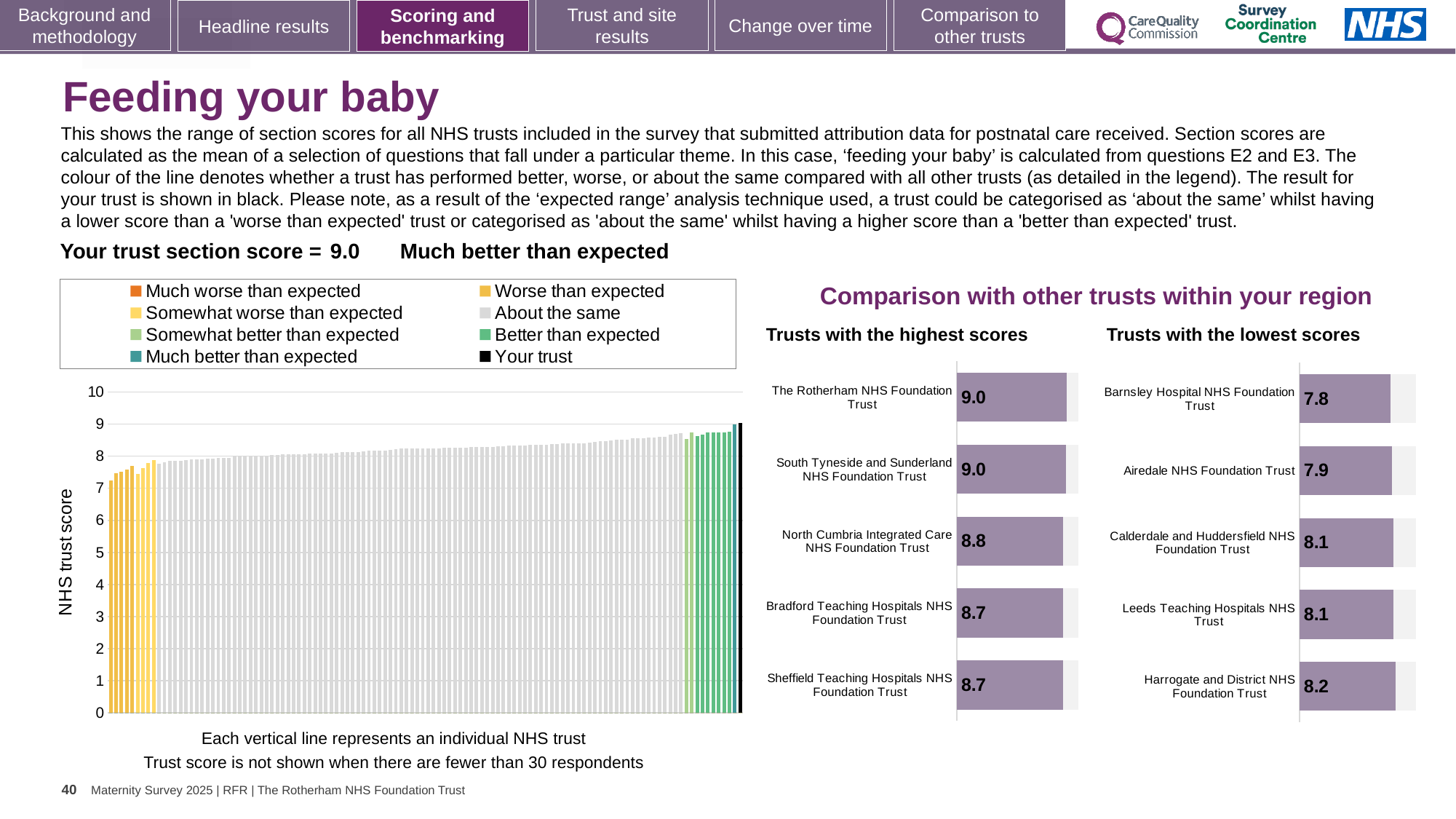
In the 'Trusts with the highest scores' chart, what is the score for North Cumbria Integrated Care NHS Foundation Trust? 8.8 In the main 'NHS trust score' chart, do the bar values rise or fall from left to right? Rise In the 'Trusts with the lowest scores' chart, what is the difference between the score for Harrogate and District NHS Foundation Trust and the score for Barnsley Hospital NHS Foundation Trust? 0.4 In the 'Trusts with the highest scores' chart, which has the larger score: North Cumbria Integrated Care NHS Foundation Trust or Bradford Teaching Hospitals NHS Foundation Trust? North Cumbria Integrated Care NHS Foundation Trust In the 'Trusts with the lowest scores' chart, which trust has the lowest score? Barnsley Hospital NHS Foundation Trust In the 'Trusts with the highest scores' chart, what is the difference between the score for The Rotherham NHS Foundation Trust and the score for Sheffield Teaching Hospitals NHS Foundation Trust? 0.3 In the 'Trusts with the lowest scores' chart, which trust has the highest score? Harrogate and District NHS Foundation Trust In the main 'NHS trust score' chart, is the value of the leftmost bar greater or less than 8? less In the 'Trusts with the lowest scores' chart, what is the score for Airedale NHS Foundation Trust? 7.9 In the 'Trusts with the lowest scores' chart, how many trusts are shown? 5 What kind of chart is the main 'NHS trust score' chart? Bar chart In the main 'NHS trust score' chart, how many entries does the legend list? 8